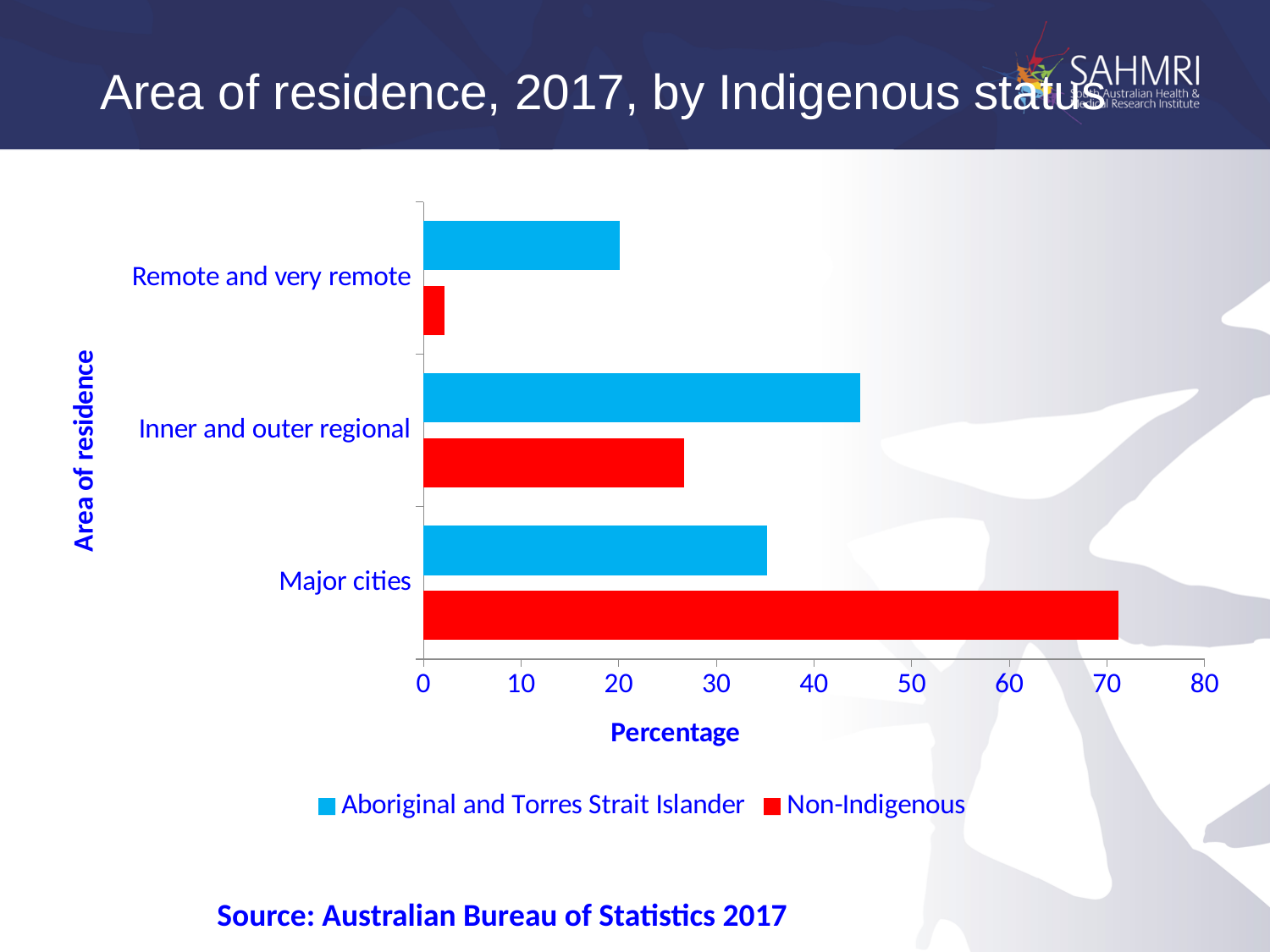
For Major cities, which series has the larger value: Aboriginal and Torres Strait Islander or Non-Indigenous? Non-Indigenous Which area of residence has the lowest value for Non-Indigenous? Remote and very remote What kind of chart is shown on the slide? bar chart Is the Non-Indigenous value for Remote and very remote greater or less than 10? less Which area of residence has the highest value for Aboriginal and Torres Strait Islander? Inner and outer regional How many area-of-residence categories are shown on the chart? 3 Which area of residence has the lowest value for Aboriginal and Torres Strait Islander? Remote and very remote What is the label of the x axis? Percentage Which area of residence has the highest value for Non-Indigenous? Major cities Is the Non-Indigenous value for Major cities greater or less than 60? greater For Remote and very remote, which series has the larger value: Aboriginal and Torres Strait Islander or Non-Indigenous? Aboriginal and Torres Strait Islander How many series does the legend list? 2